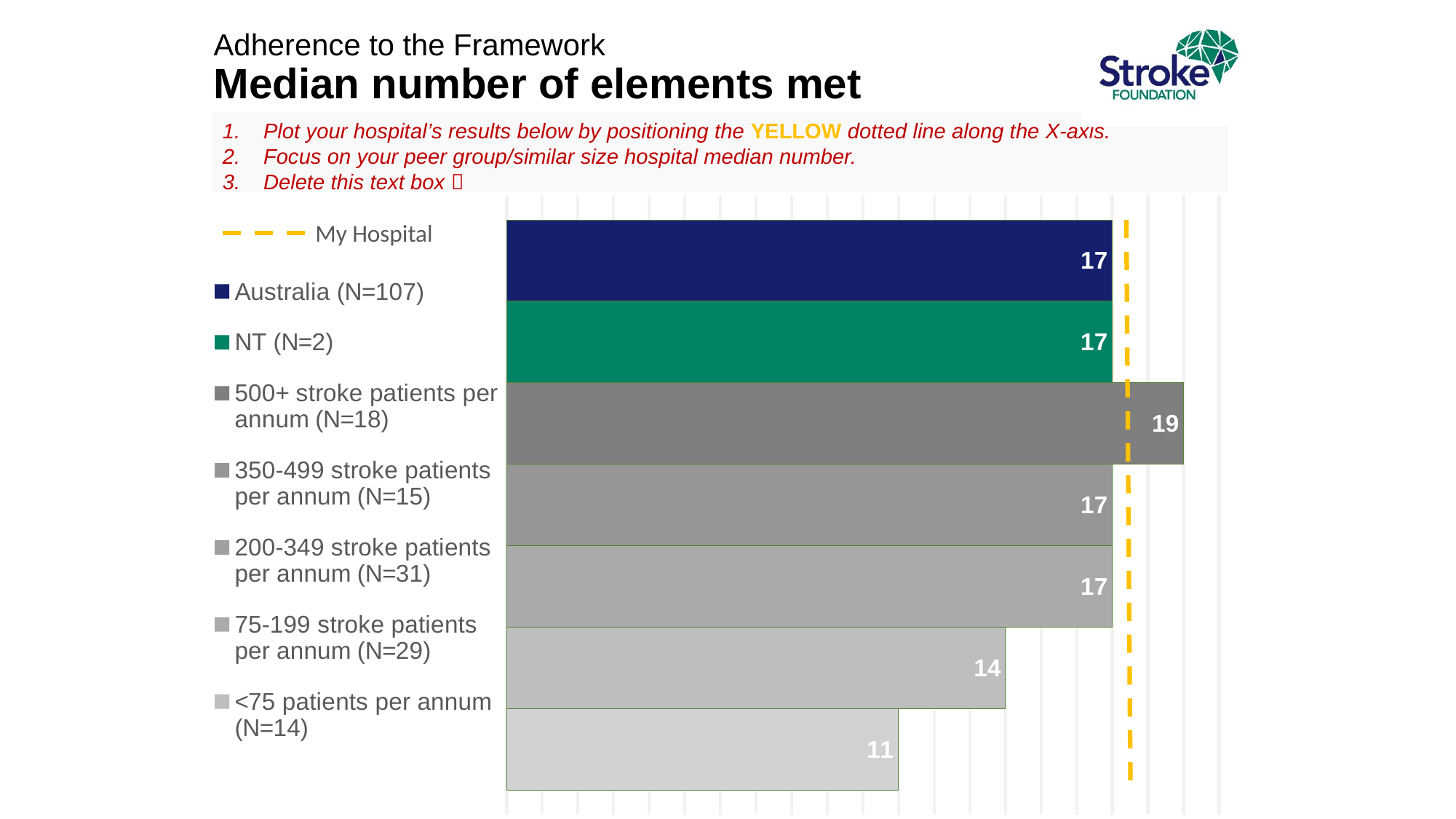
How many bars are plotted in the chart? 7 What is the median number of elements met for Australia (N=107)? 17 What is the difference between the value for Australia (N=107) and the value for 75-199 stroke patients per annum (N=29)? 3 What colour is the dotted line labelled My Hospital in the legend? Yellow Which group has the highest median number of elements met? 500+ stroke patients per annum (N=18) What is the value shown for <75 patients per annum (N=14)? 11 Which group has the lowest median number of elements met? <75 patients per annum (N=14) What kind of chart is shown on the slide? Bar chart What is the value shown for 75-199 stroke patients per annum (N=29)? 14 Which is larger: the value for 200-349 stroke patients per annum or the value for 75-199 stroke patients per annum? 200-349 stroke patients per annum What is the difference between the value for 500+ stroke patients per annum and the value for <75 patients per annum? 8 What is the value shown for 500+ stroke patients per annum (N=18)? 19